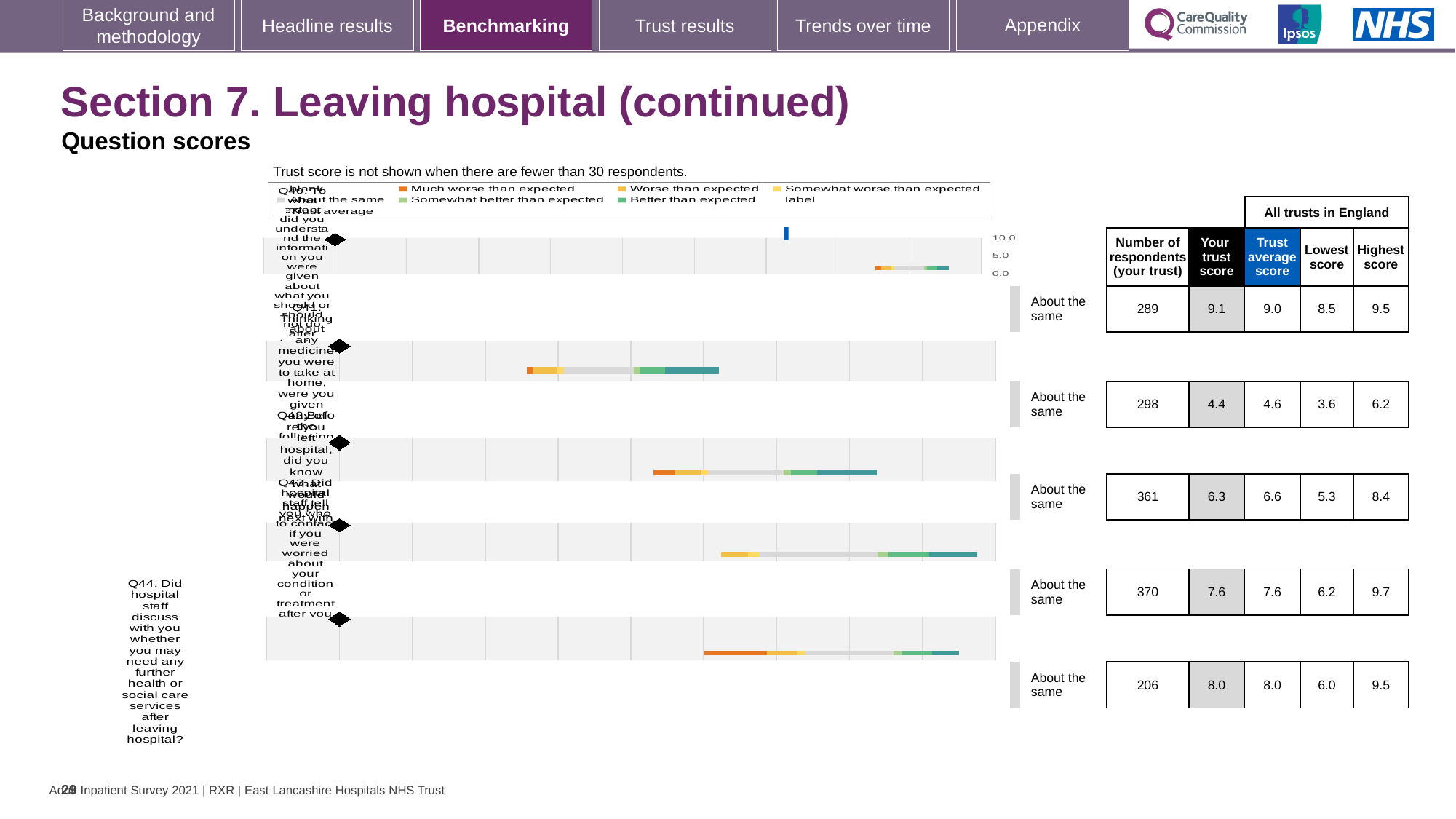
How many respondents from your trust answered Q44 (about discussing further health or social care services after leaving hospital)? 206 What is the trust average score for the first question row (Q40)? 9.0 What kind of chart is used to show the question scores? Bar chart How many question rows are shown in the chart? 5 Is the 'Your trust score' for the second question row (Q41) greater or less than 5.0? less What is the 'Your trust score' for Q44? 8.0 What benchmark category is shown for Q44? About the same For the third question row (Q42), which is larger: your trust score or the trust average score? Trust average score (6.6) Which question row has the lowest 'Your trust score'? Q41 (4.4) What is the lowest score across all trusts in England for the fourth question row (Q43)? 6.2 Which question row has the highest 'Your trust score'? Q40 (9.1) For Q44, what is the difference between the highest score and the lowest score across all trusts in England? 3.5